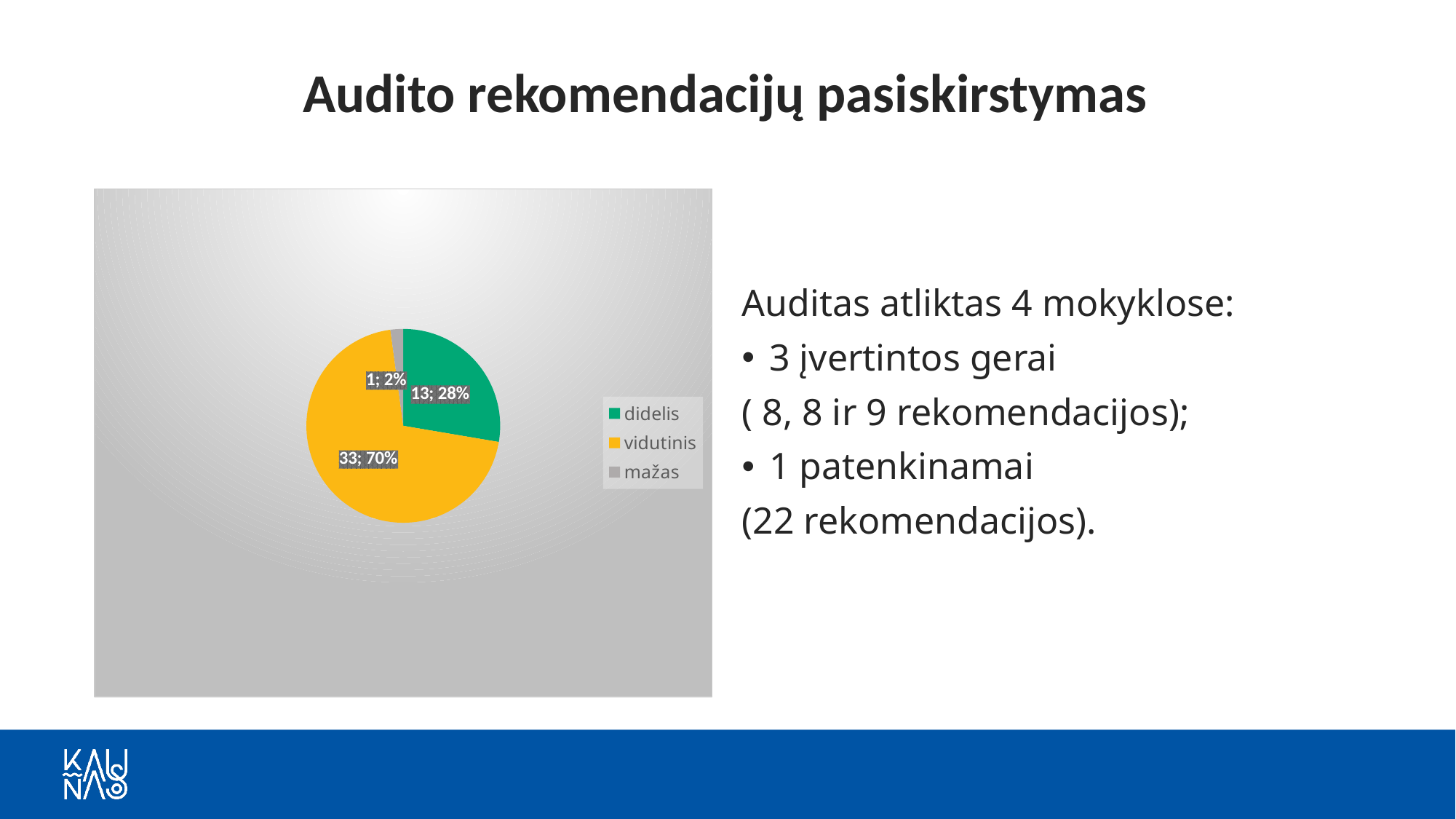
Which colour represents 'didelis' in the pie chart? green What is the count shown for the 'didelis' slice? 13 How many slices does the pie chart have? 3 What share of the pie does the 'didelis' slice represent? 28% Which category has the largest slice? vidutinis What share of the pie does the 'vidutinis' slice represent? 70% Which category has the smallest slice? mažas What kind of chart is shown on the slide? pie chart How many entries does the legend list? 3 What is the count shown for the 'mažas' slice? 1 What is the count shown for the 'vidutinis' slice? 33 What is the difference between the counts for 'vidutinis' and 'didelis'? 20